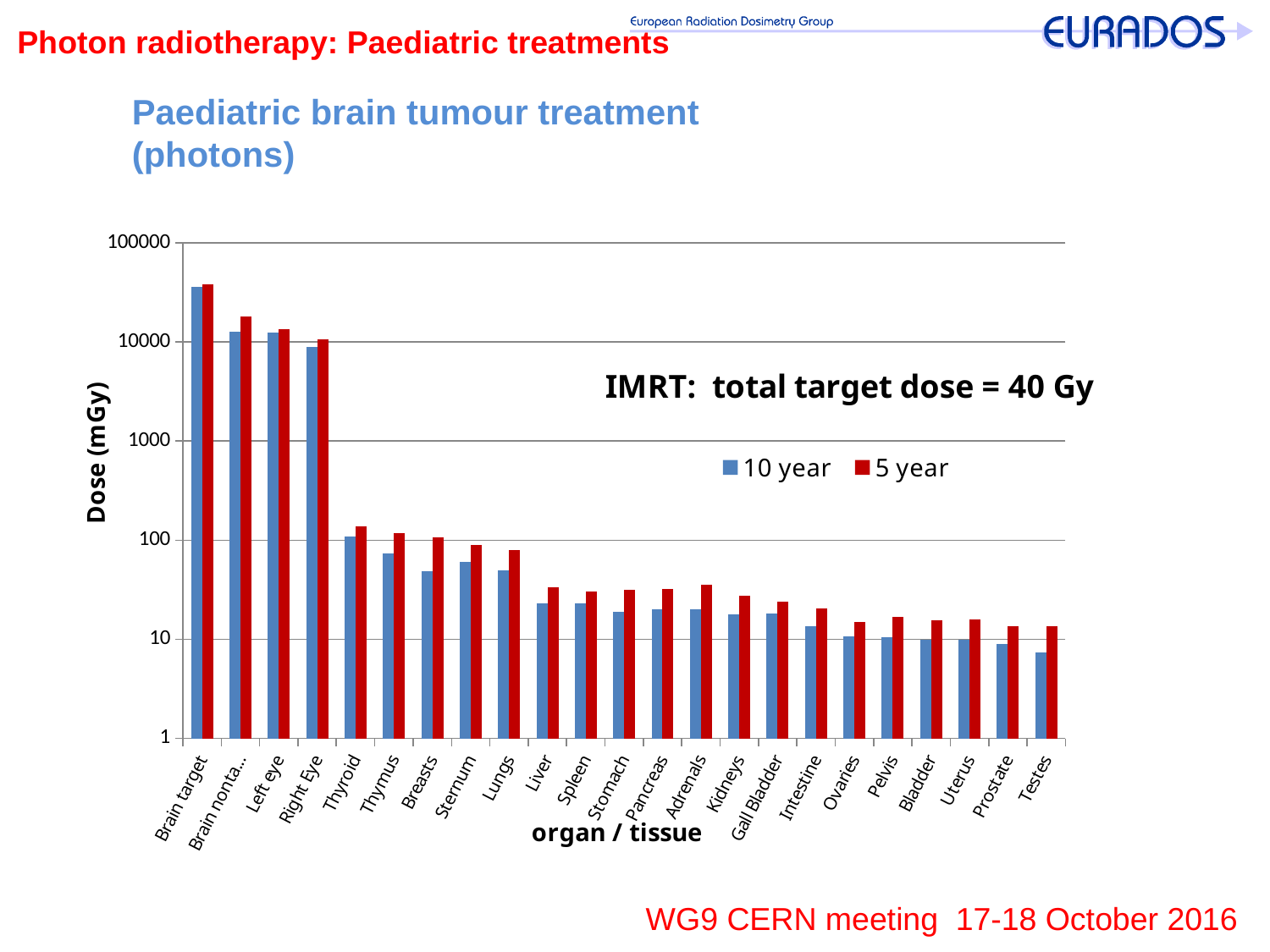
How many series does the legend list? 2 Is the 5 year dose for Thyroid greater or less than 100 mGy? greater Is the 10 year dose for Breasts greater or less than 100 mGy? less Which organ/tissue has the lowest dose for the 10 year series? Testes Do the doses generally rise or fall moving from left to right along the x axis? fall What kind of chart is shown on the slide? bar chart Which is larger, the 10 year dose for Left eye or the 10 year dose for Thyroid? Left eye Which organ/tissue has the highest dose for the 5 year series? Brain target How many organ/tissue categories are plotted on the x axis? 23 Is the 5 year dose for Liver greater or less than 10 mGy? greater What are the two series named in the legend? 10 year and 5 year